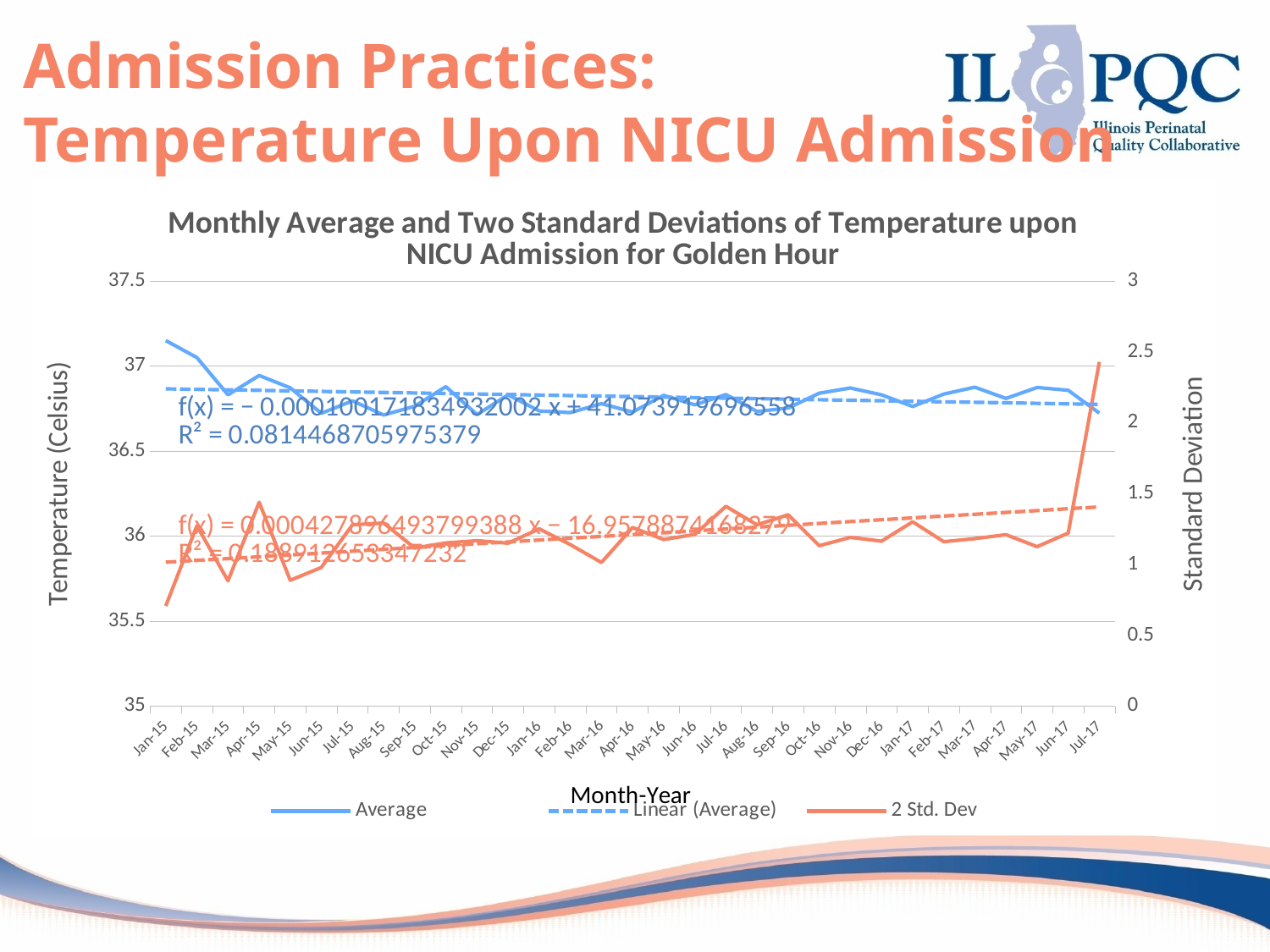
Is the 2 Std. Dev value for Jan-15 greater or less than 1? less What is the label of the left vertical axis? Temperature (Celsius) In which month is the Average temperature highest? Jan-15 Is the 2 Std. Dev value for Jul-17 greater or less than 2? greater What kind of chart is shown on the slide? line chart Which is larger, the Average temperature for Jan-15 or for Jul-17? Jan-15 Is the Average temperature for Jan-15 greater or less than 37? greater In which month is the 2 Std. Dev value lowest? Jan-15 In which month is the 2 Std. Dev value highest? Jul-17 How many months are plotted along the x axis, from Jan-15 to Jul-17? 31 How many series does the legend list? 3 Does the linear trend line for the Average series rise or fall from left to right? fall